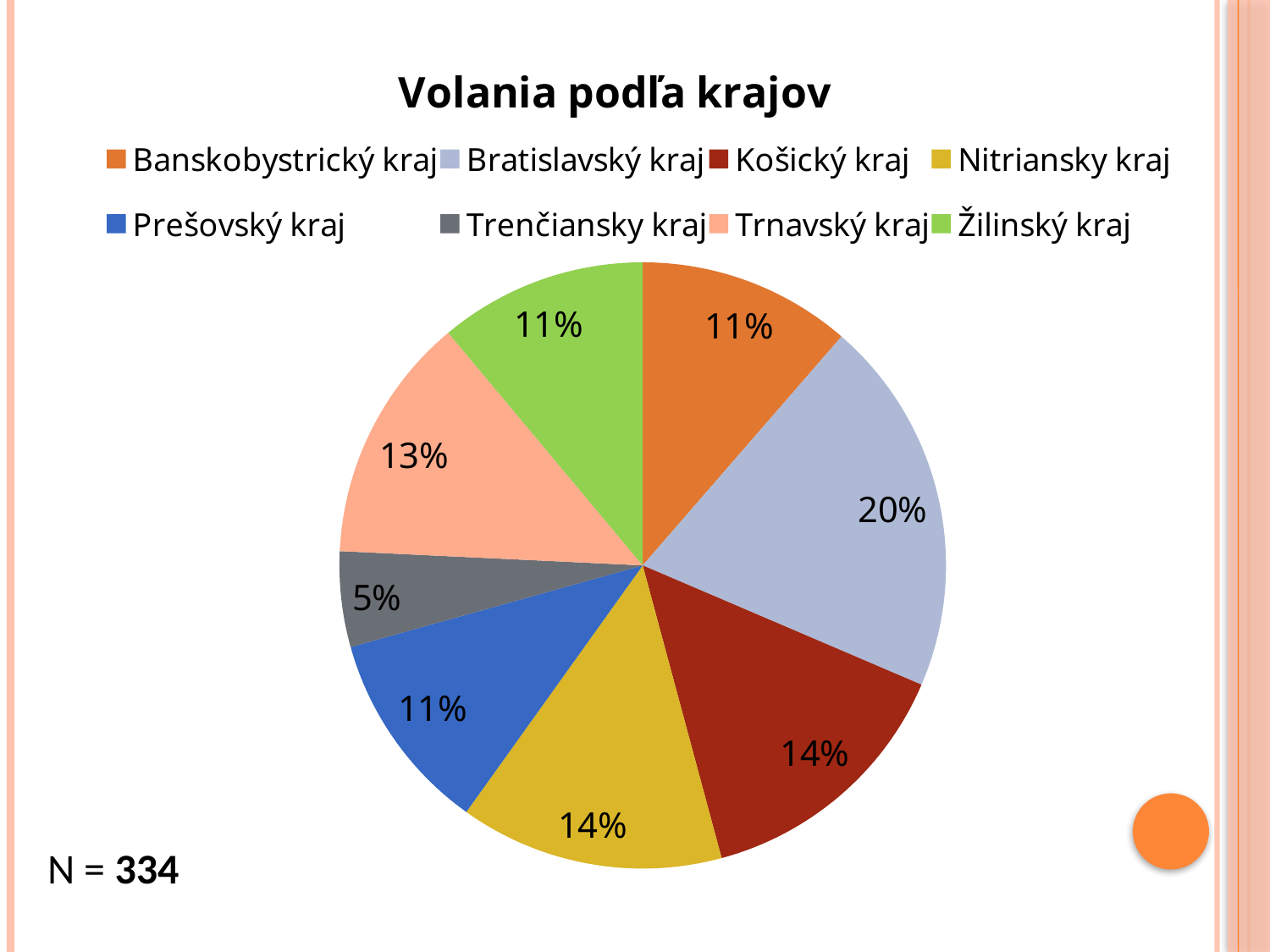
What is the title of the chart? Volania podľa krajov What is the difference in percentage points between Bratislavský kraj and Trenčiansky kraj? 15 percentage points How many regions (slices) are shown in the pie chart? 8 Which region has the largest slice of the pie? Bratislavský kraj Which has a larger share, Trnavský kraj or Prešovský kraj? Trnavský kraj Which region has the smallest slice of the pie? Trenčiansky kraj What share of the pie does Trenčiansky kraj have? 5% What kind of chart is shown on the slide? pie chart What share of the pie does Bratislavský kraj have? 20% What share of the pie does Košický kraj have? 14% What share of the pie does Žilinský kraj have? 11% What share of the pie does Trnavský kraj have? 13%